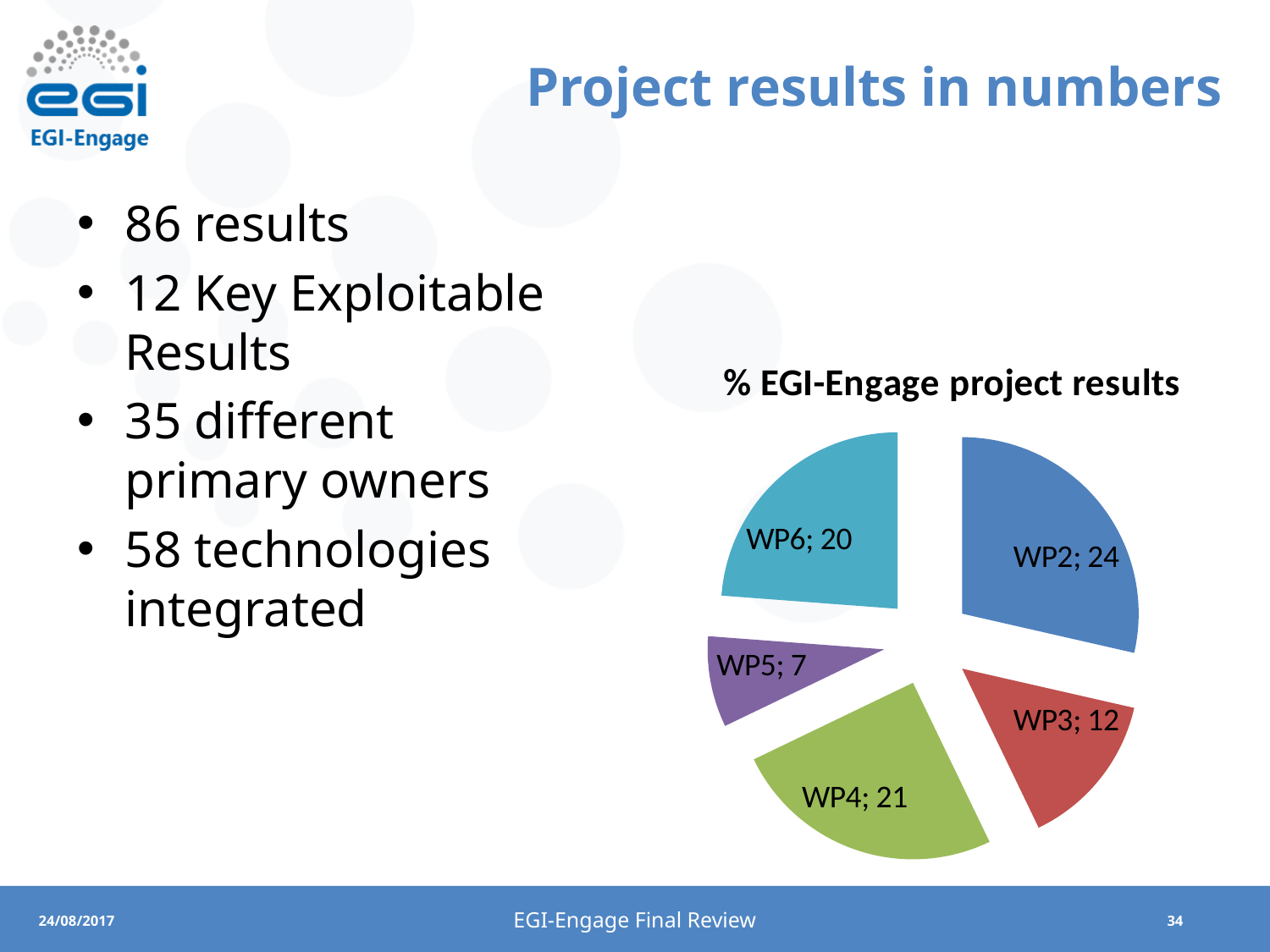
What value is shown for WP6 in the pie chart? 20 What kind of chart is shown on the slide? pie chart What value is shown for WP5 in the pie chart? 7 What value is shown for WP2 in the pie chart? 24 Which work package has the smallest slice in the pie chart? WP5 Which is larger, the value for WP4 or the value for WP6? WP4 How many slices does the pie chart have? 5 What value is shown for WP4 in the pie chart? 21 What is the title of the chart? % EGI-Engage project results Which work package has the largest slice in the pie chart? WP2 What is the difference between the values for WP2 and WP3? 12 What value is shown for WP3 in the pie chart? 12